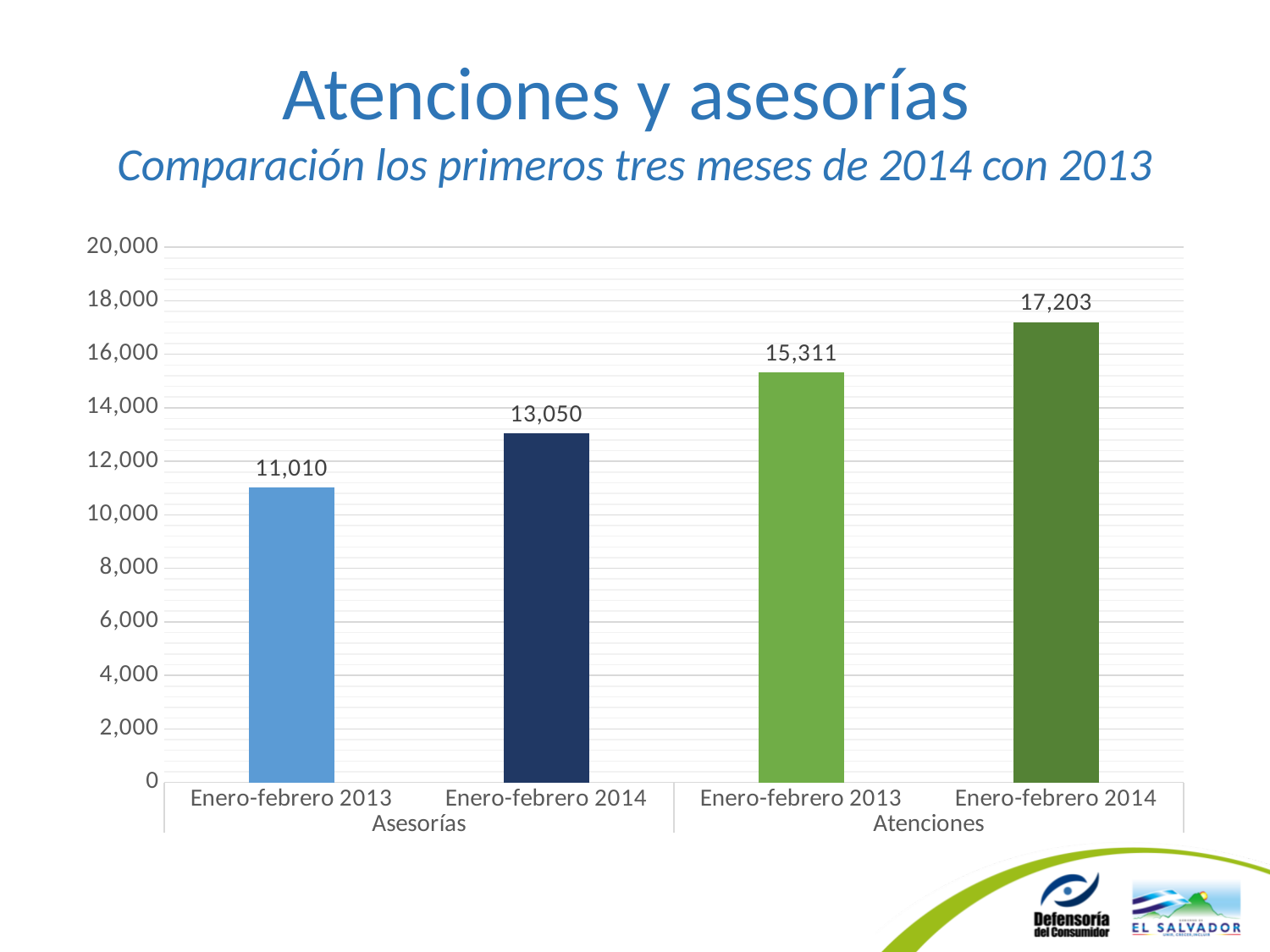
What is the title of the slide? Atenciones y asesorías What is the value for Asesorías in Enero-febrero 2013? 11,010 What is the value for Asesorías in Enero-febrero 2014? 13,050 Which bar has the highest value? Atenciones, Enero-febrero 2014 What is the difference between Asesorías in Enero-febrero 2014 and Enero-febrero 2013? 2,040 Which is larger: Asesorías in Enero-febrero 2014 or Atenciones in Enero-febrero 2013? Atenciones in Enero-febrero 2013 What is the value for Atenciones in Enero-febrero 2014? 17,203 What is the value for Atenciones in Enero-febrero 2013? 15,311 How many bars are plotted in the chart? 4 What kind of chart is shown on the slide? Bar chart What is the difference between Atenciones in Enero-febrero 2014 and Enero-febrero 2013? 1,892 Which bar has the lowest value? Asesorías, Enero-febrero 2013